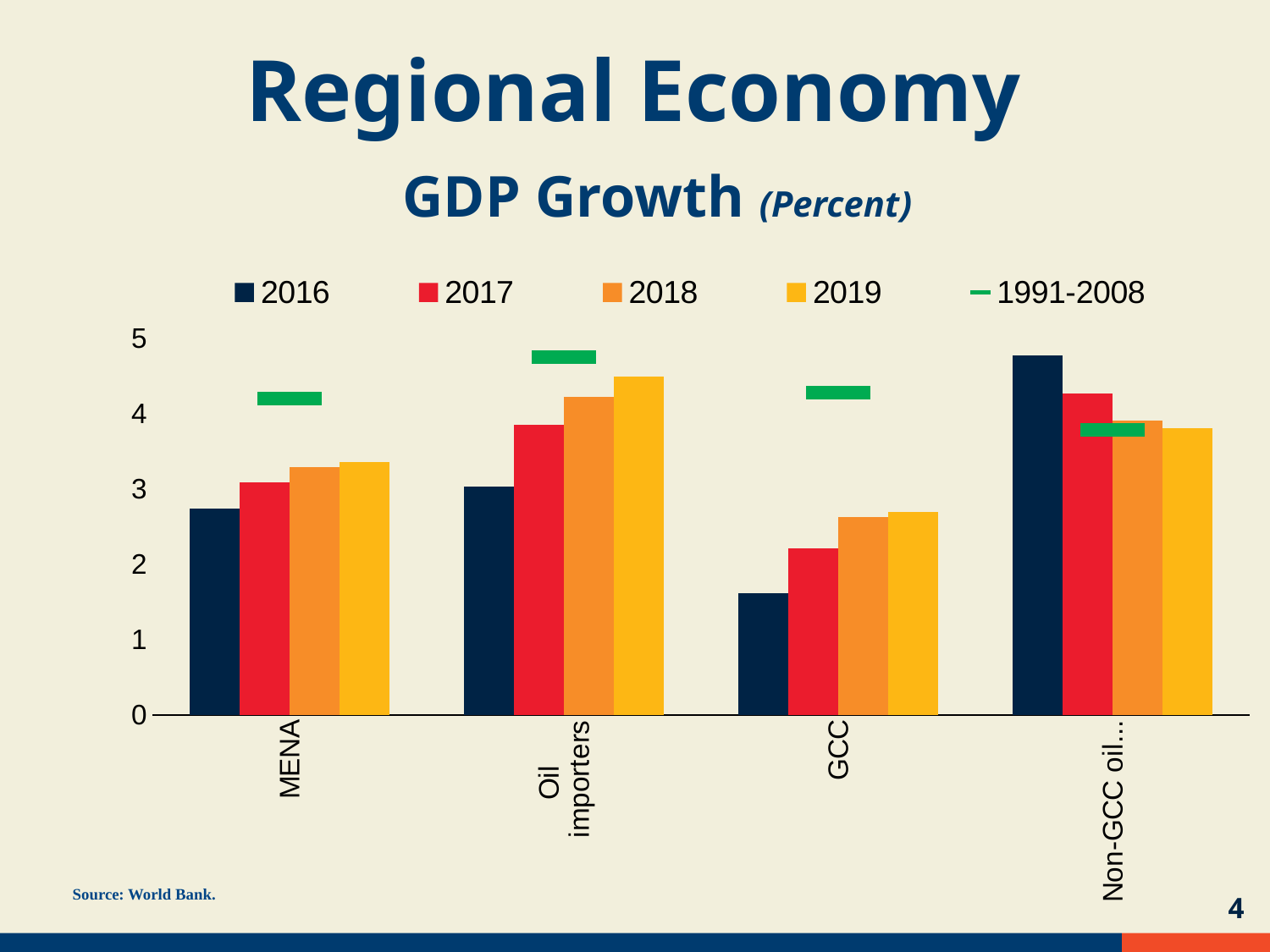
Is the 2019 value for Oil importers greater or less than 4? greater What source is cited for the chart? World Bank Which category has the highest 2019 bar? Oil importers How many categories are shown on the x axis? 4 Do the bars for MENA rise or fall from 2016 to 2019? Rise Is the 2016 value for MENA greater or less than 3? less Which category has the lowest 2016 bar? GCC What is the title of the chart? GDP Growth (Percent) Which is larger, the 2019 value for MENA or the 2019 value for Oil importers? Oil importers Is the 2016 value for GCC greater or less than 2? less What kind of chart is shown on the slide? Bar chart How many series does the legend list? 5